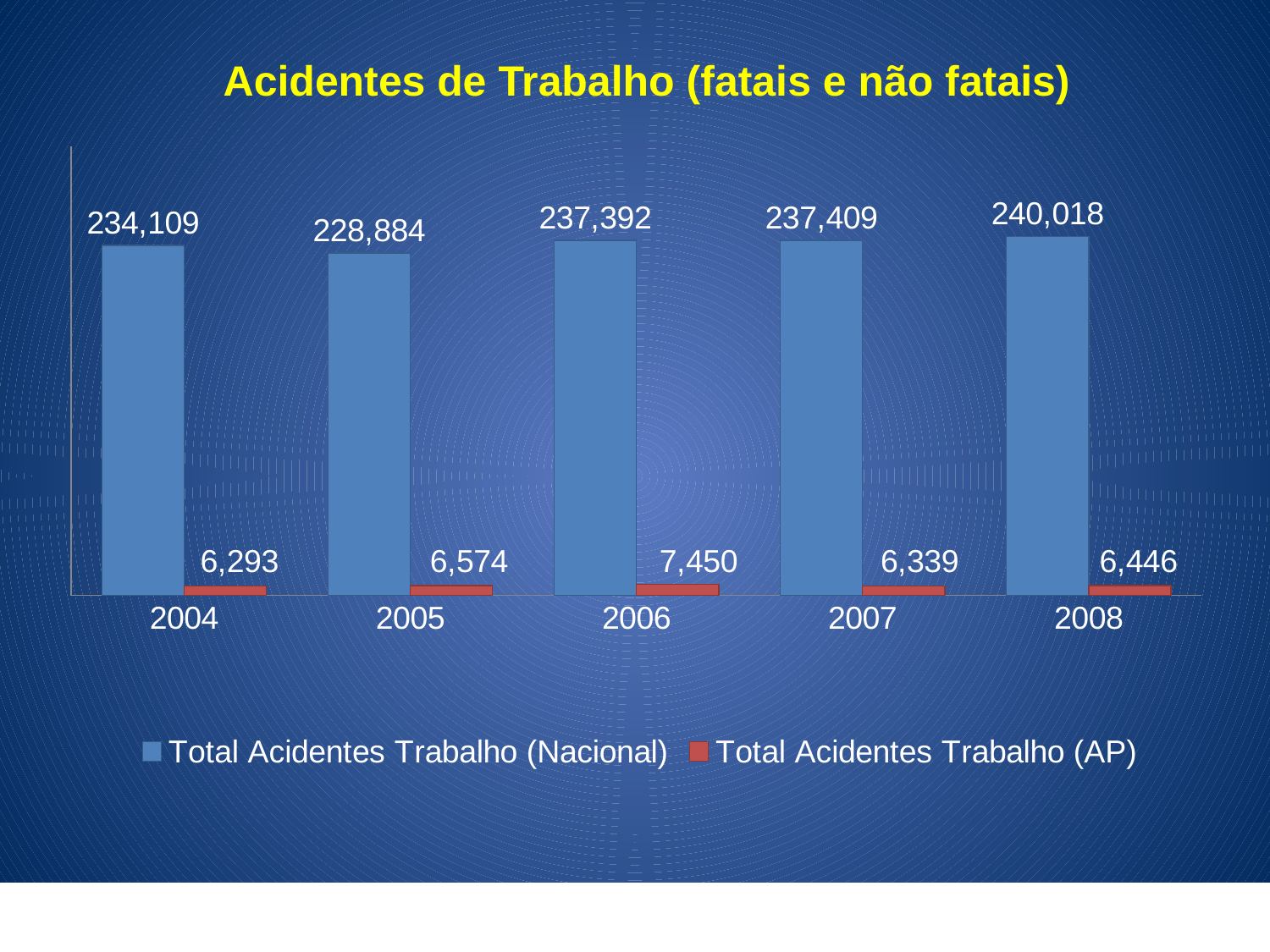
What is the value of Total Acidentes Trabalho (Nacional) for 2006? 237,392 Which is larger, Total Acidentes Trabalho (AP) in 2007 or in 2008? 2008 How many series does the legend list? 2 What kind of chart is shown on the slide? bar chart In which year is Total Acidentes Trabalho (AP) highest? 2006 What is the title of the chart? Acidentes de Trabalho (fatais e não fatais) What is the value of Total Acidentes Trabalho (AP) for 2005? 6,574 What is the difference between Total Acidentes Trabalho (Nacional) in 2008 and in 2004? 5,909 In which year is Total Acidentes Trabalho (Nacional) lowest? 2005 How many years are shown on the x axis? 5 What is the difference between Total Acidentes Trabalho (AP) in 2006 and in 2004? 1,157 What is the value of Total Acidentes Trabalho (Nacional) for 2008? 240,018